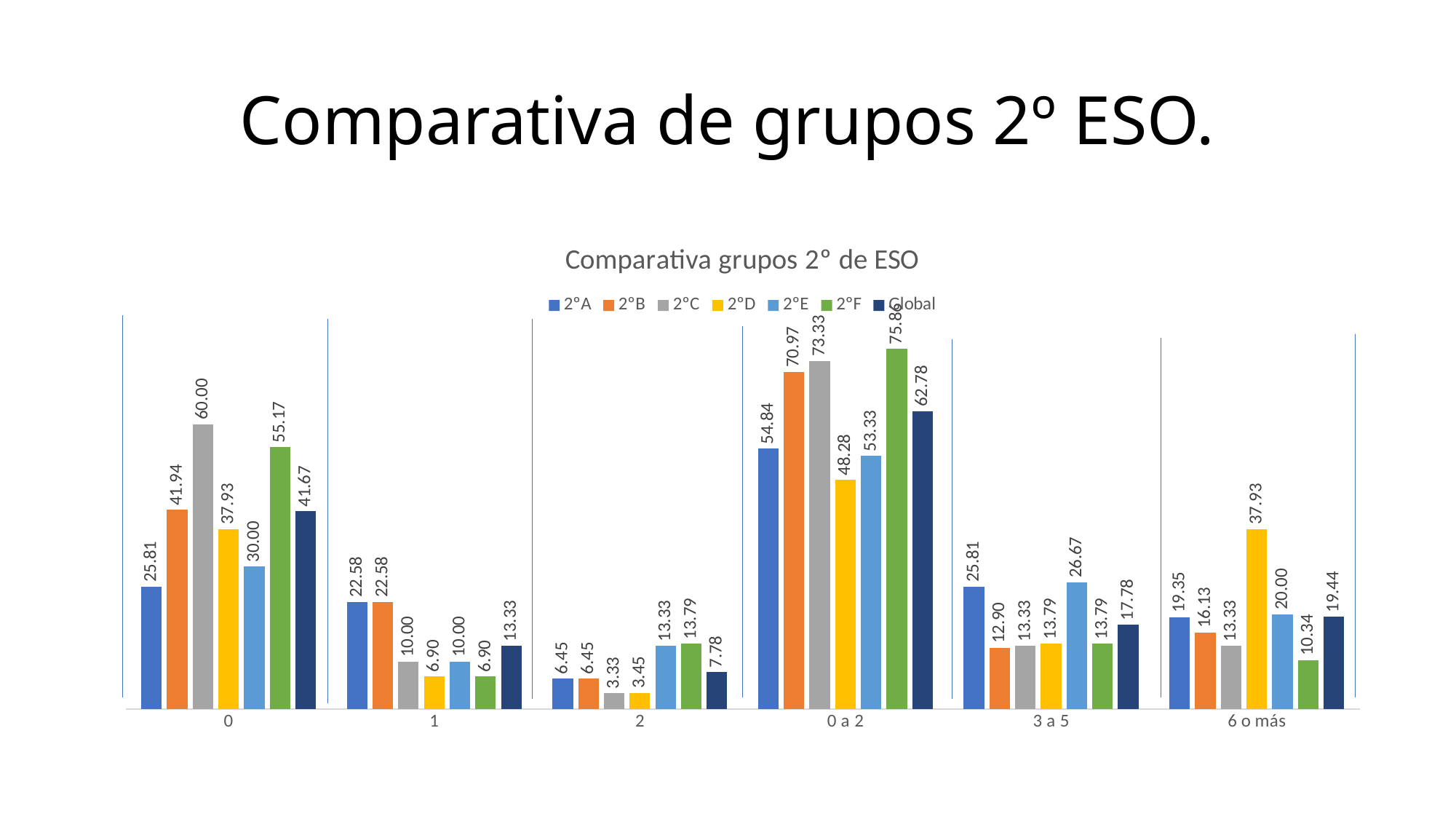
What is the Global value for the "0 a 2" category? 62.78 What is the difference between the 2ºC and 2ºA values in the "0" category? 34.19 How many categories are shown on the x axis? 6 In the "3 a 5" category, which is larger: the value for 2ºE or the value for 2ºB? 2ºE What is the value for 2ºC in the "0" category? 60.00 What kind of chart is shown on the slide? Bar chart How many series does the legend list? 7 Which group has the highest value in the "6 o más" category? 2ºD What is the value for 2ºD in the "6 o más" category? 37.93 What is the title of the chart? Comparativa grupos 2º de ESO What is the value for 2ºF in the "1" category? 6.90 Which group has the lowest value in the "2" category? 2ºC